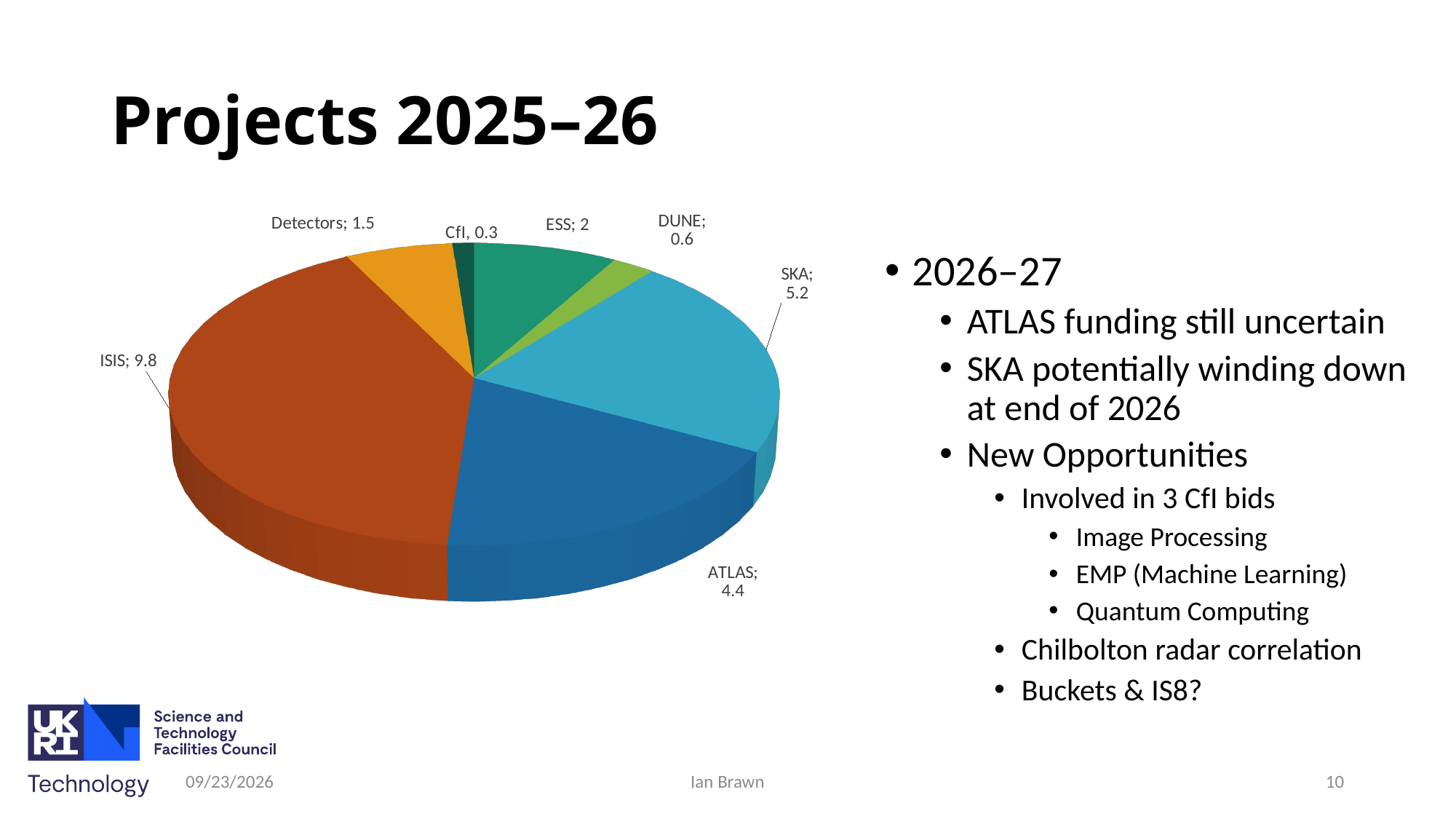
Which is larger, the value for ESS or the value for Detectors? ESS What is the difference between the values for SKA and ATLAS? 0.8 What is the value shown for ISIS in the pie chart? 9.8 What kind of chart is shown on the slide? Pie chart Which project has the smallest slice in the pie chart? CfI What is the value shown for ATLAS in the pie chart? 4.4 What is the value shown for SKA in the pie chart? 5.2 What is the difference between the values for ISIS and ATLAS? 5.4 Which project has the largest slice in the pie chart? ISIS How many slices does the pie chart have? 7 What is the total of all the slice values in the pie chart? 23.8 What is the value shown for CfI in the pie chart? 0.3